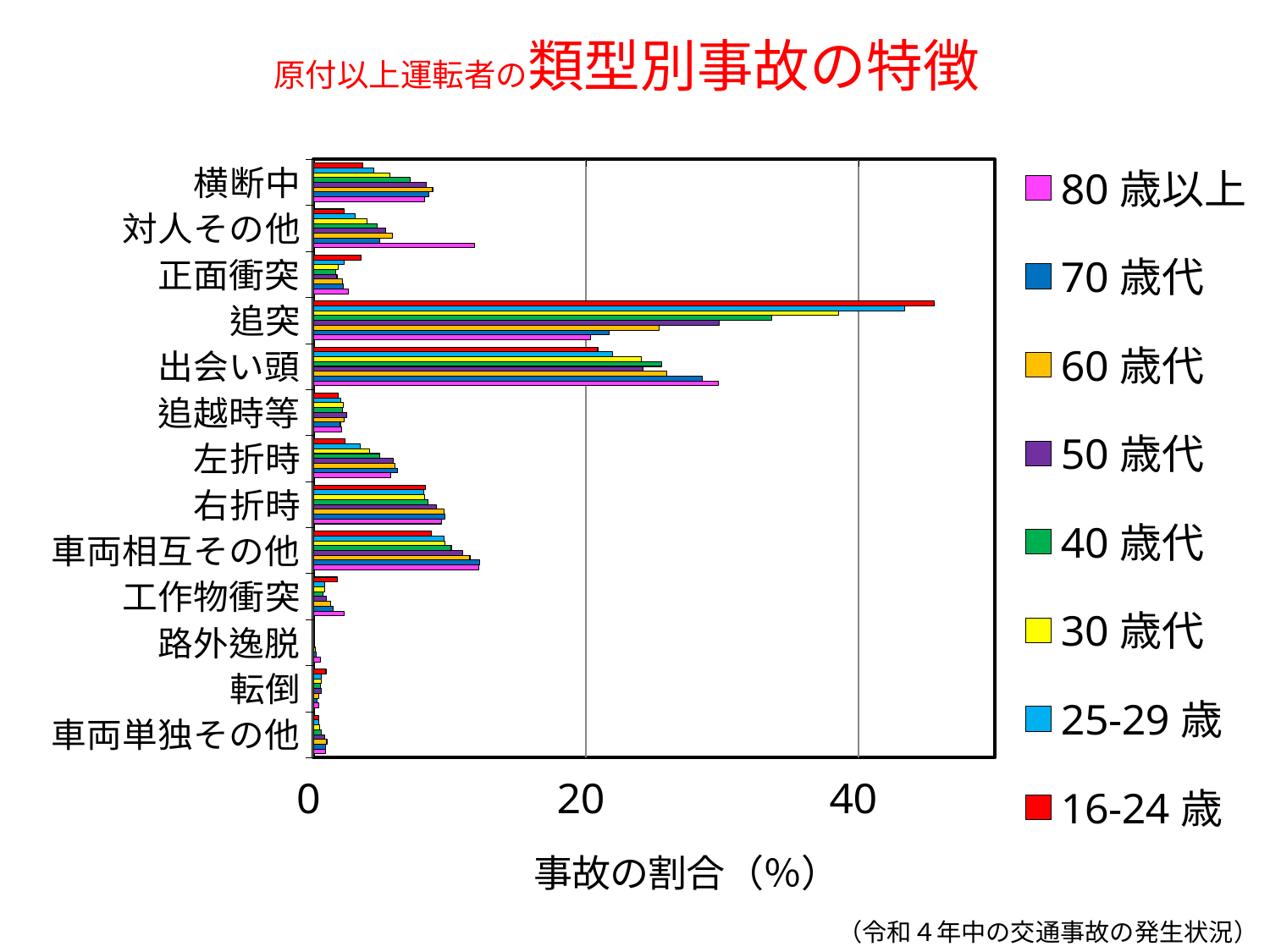
Is the value for 横断中 in the 16-24 歳 series greater or less than 20? less Is the value for 追突 in the 16-24 歳 series greater or less than 40? greater Which category has the highest value for the 16-24 歳 series? 追突 How many accident-type categories are listed on the vertical axis? 13 What is the label of the horizontal axis? 事故の割合（%） Is the value for 追突 in the 70 歳代 series greater or less than 40? less Which age-group series has the highest value for 追突? 16-24 歳 Which age-group series has the highest value for 対人その他? 80 歳以上 For the 80 歳以上 series, which is larger: 追突 or 出会い頭? 出会い頭 What kind of chart is shown on the slide? bar chart How many age-group series does the legend list? 8